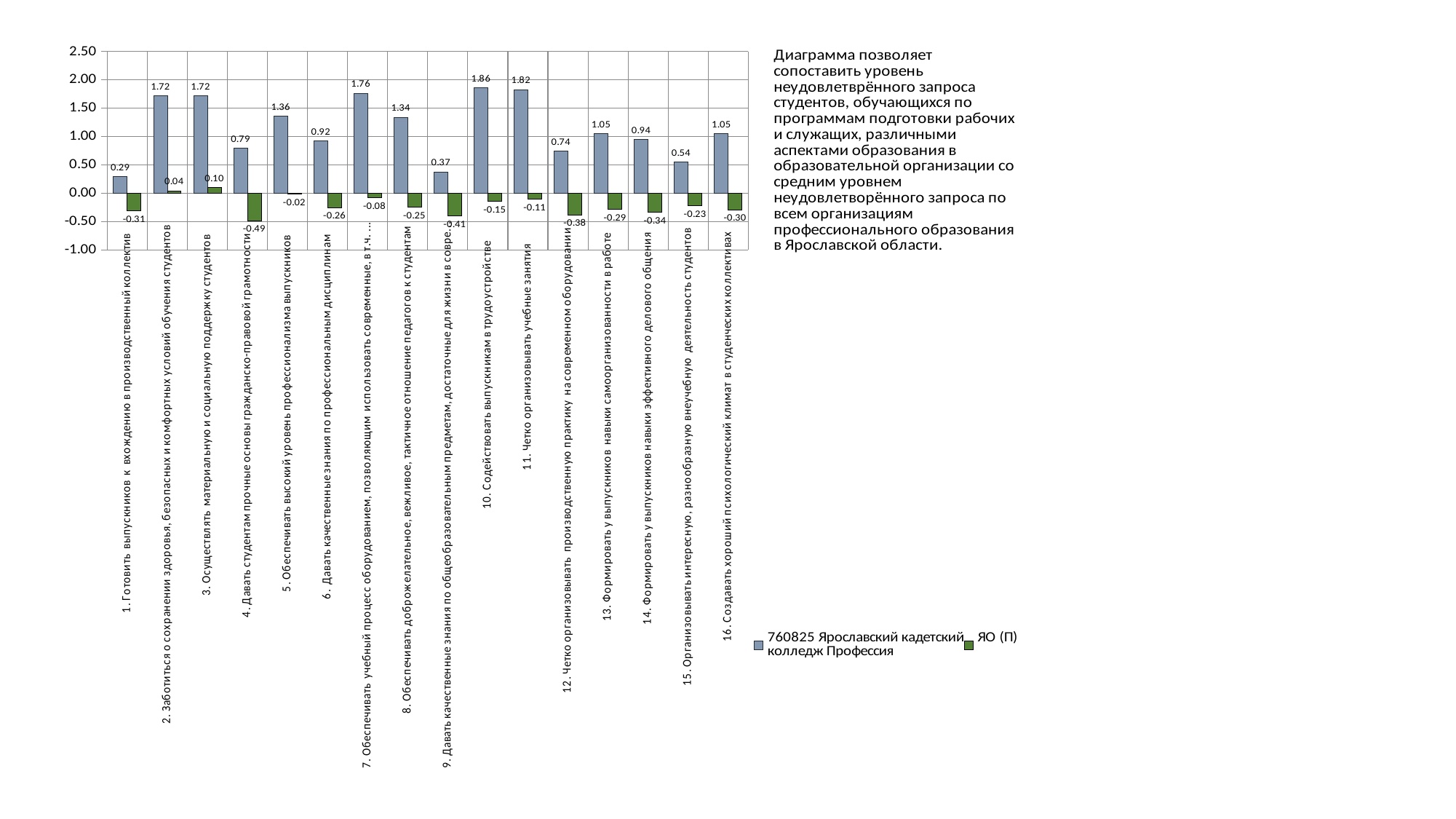
How many categories are plotted along the x axis? 16 What is the value for the series 'ЯО (П)' for category '4. Давать студентам прочные основы гражданско-правовой грамотности'? -0.49 For the series '760825 Ярославский кадетский колледж Профессия', which is larger: the value for category 5 (Обеспечивать высокий уровень профессионализма выпускников) or category 8 (Обеспечивать доброжелательное, вежливое, тактичное отношение педагогов к студентам)? Category 5 (1.36) Which category has the lowest value for the series 'ЯО (П)'? 4. Давать студентам прочные основы гражданско-правовой грамотности How many series does the legend list? 2 What colour are the bars for the series 'ЯО (П)'? Green Is the value for the series '760825 Ярославский кадетский колледж Профессия' for category '7. Обеспечивать учебный процесс оборудованием...' greater or less than 1.50? greater Which category has the highest value for the series '760825 Ярославский кадетский колледж Профессия'? 10. Содействовать выпускникам в трудоустройстве What type of chart is shown on the slide? Bar chart What is the difference between the two series for category '11. Четко организовывать учебные занятия'? 1.93 What is the value for the series '760825 Ярославский кадетский колледж Профессия' for category '10. Содействовать выпускникам в трудоустройстве'? 1.86 Which category has the lowest value for the series '760825 Ярославский кадетский колледж Профессия'? 1. Готовить выпускников к вхождению в производственный коллектив